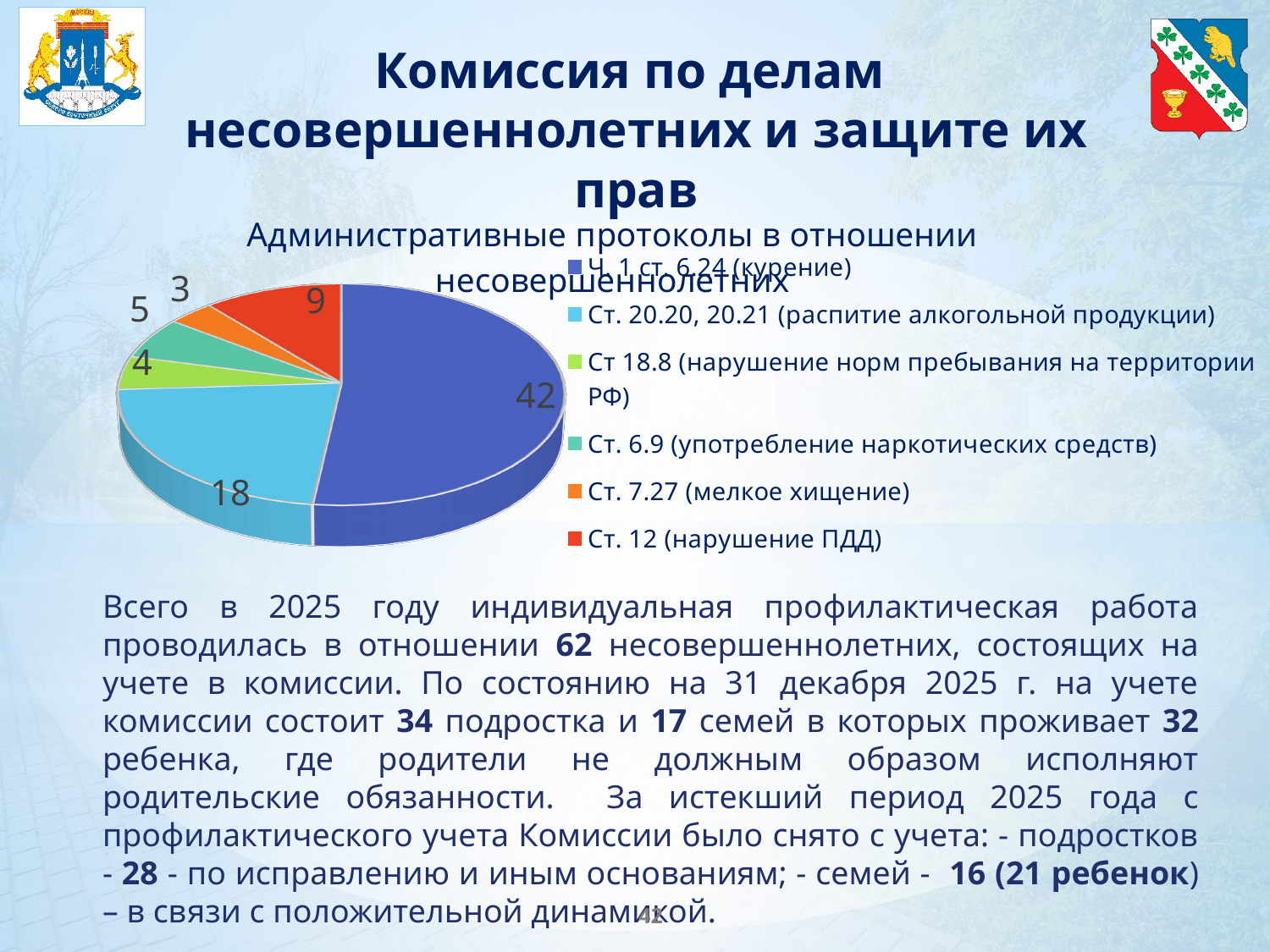
What kind of chart is shown on the slide? pie chart What is the difference between the values for Ч. 1 ст. 6.24 (курение) and Ст. 20.20, 20.21 (распитие алкогольной продукции)? 24 What is the value for Ч. 1 ст. 6.24 (курение)? 42 How many entries does the chart legend list? 6 What is the title of the chart? Административные протоколы в отношении несовершеннолетних What is the value for Ст. 20.20, 20.21 (распитие алкогольной продукции)? 18 What is the value for Ст. 7.27 (мелкое хищение)? 3 What is the total of all the values shown in the pie chart? 81 Which category has the largest slice of the pie? Ч. 1 ст. 6.24 (курение) Which category has the smallest slice of the pie? Ст. 7.27 (мелкое хищение) What is the value for Ст. 12 (нарушение ПДД)? 9 Which is larger: the value for Ст. 6.9 (употребление наркотических средств) or the value for Ст 18.8 (нарушение норм пребывания на территории РФ)? Ст. 6.9 (употребление наркотических средств)